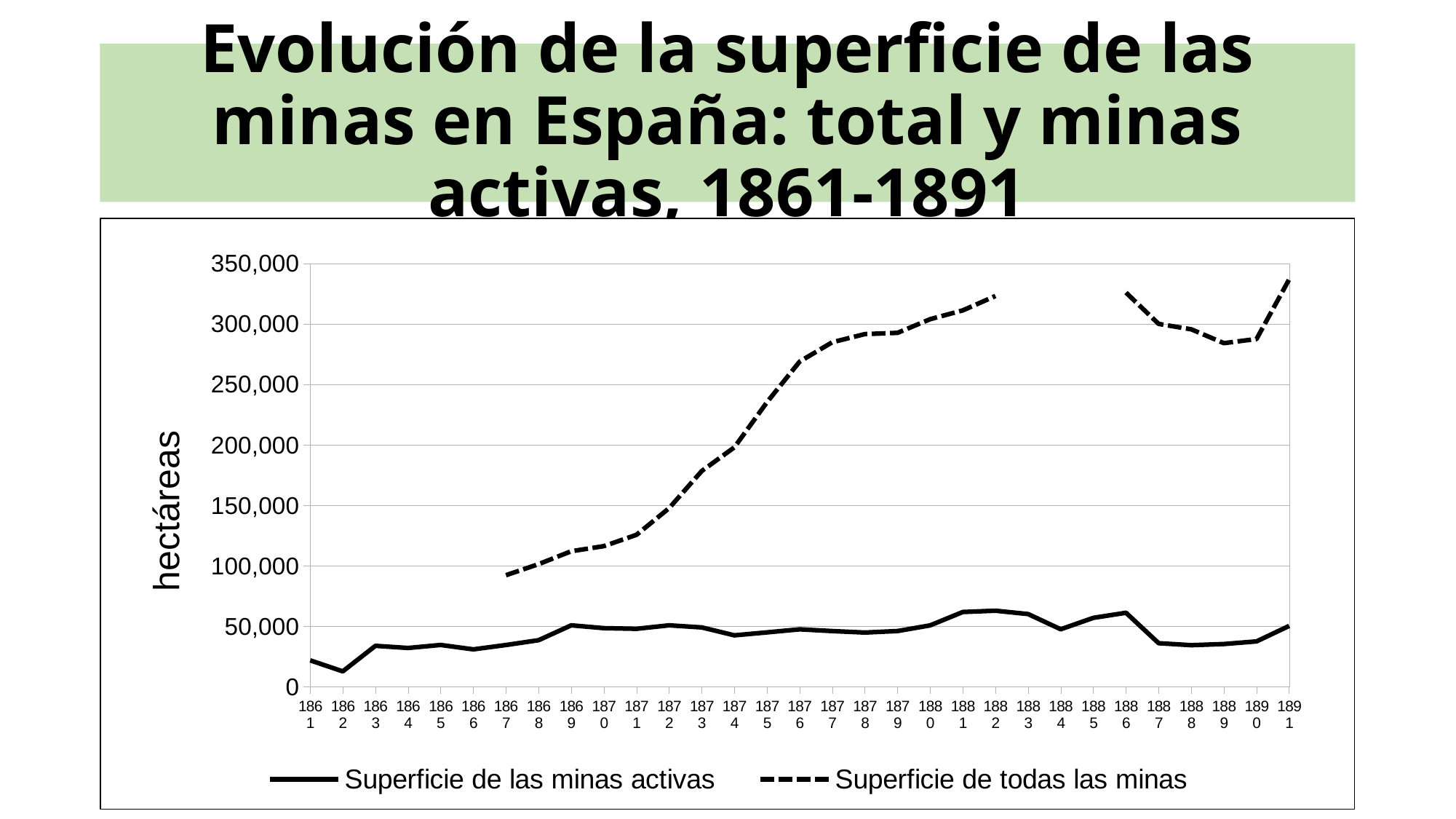
How many years are plotted along the x axis? 31 Is the value for Superficie de las minas activas in 1881 greater or less than 50,000? greater Does the Superficie de todas las minas series rise or fall between 1867 and 1882? rise Which series is drawn with a dashed line? Superficie de todas las minas Is the value for Superficie de todas las minas in 1867 greater or less than 100,000? less In 1891, which series has the larger value: Superficie de las minas activas or Superficie de todas las minas? Superficie de todas las minas How many series does the legend list? 2 In which year is the Superficie de las minas activas series at its lowest? 1862 Is the value for Superficie de todas las minas in 1891 greater or less than 300,000? greater What kind of chart is shown on the slide? line chart What is the label on the y axis? hectáreas